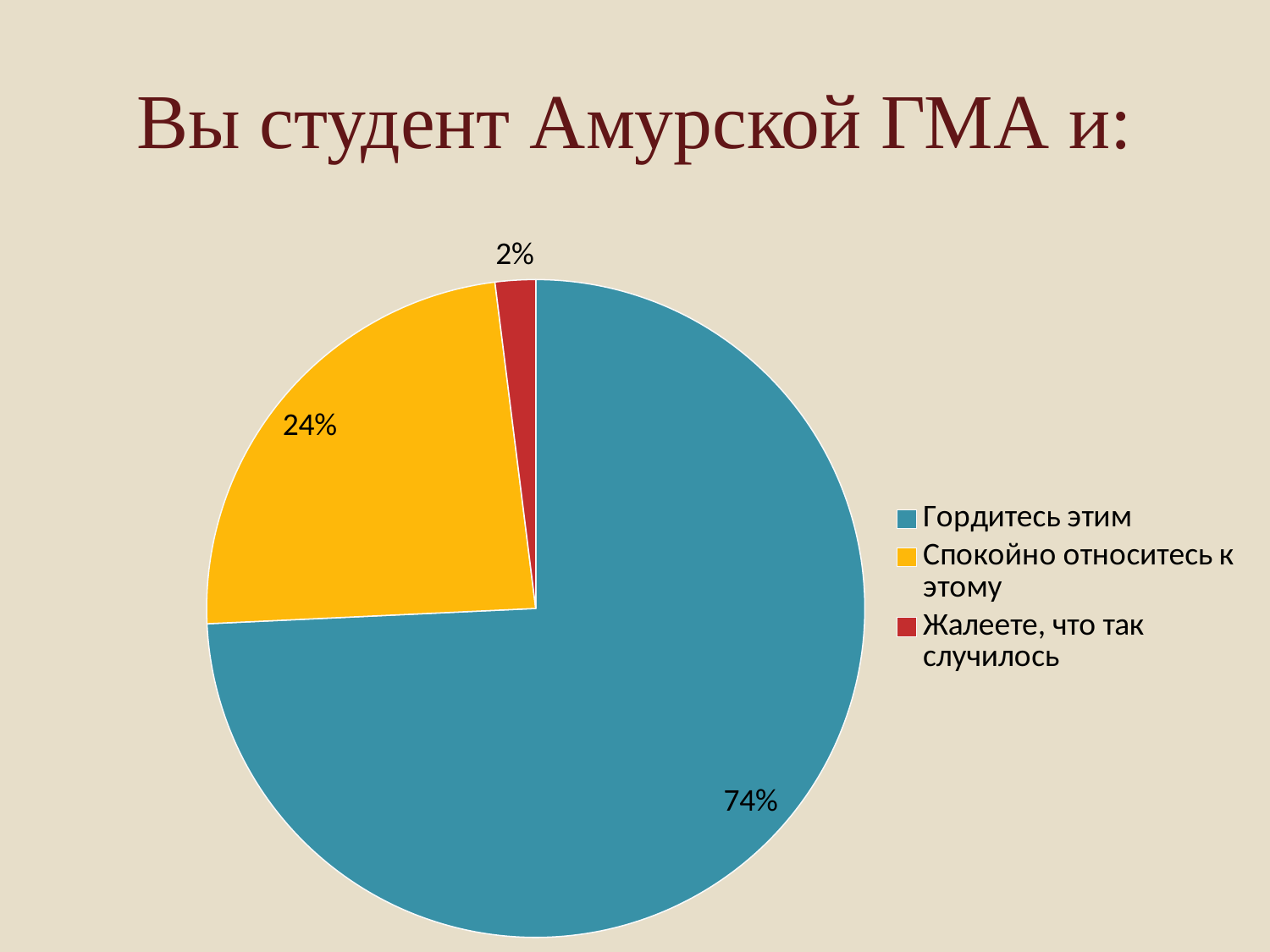
Which is larger: the share for "Спокойно относитесь к этому" or for "Жалеете, что так случилось"? Спокойно относитесь к этому What is the title of the slide? Вы студент Амурской ГМА и: What type of chart is shown on the slide? pie chart How many entries does the legend list? 3 Which answer has the largest share of the pie? Гордитесь этим What share of respondents answered "Гордитесь этим"? 74% How many slices does the pie chart have? 3 Which answer has the smallest share of the pie? Жалеете, что так случилось What colour is the slice for "Жалеете, что так случилось"? red What is the difference in percentage points between "Гордитесь этим" and "Спокойно относитесь к этому"? 50 What share of respondents answered "Спокойно относитесь к этому"? 24% What share of respondents answered "Жалеете, что так случилось"? 2%